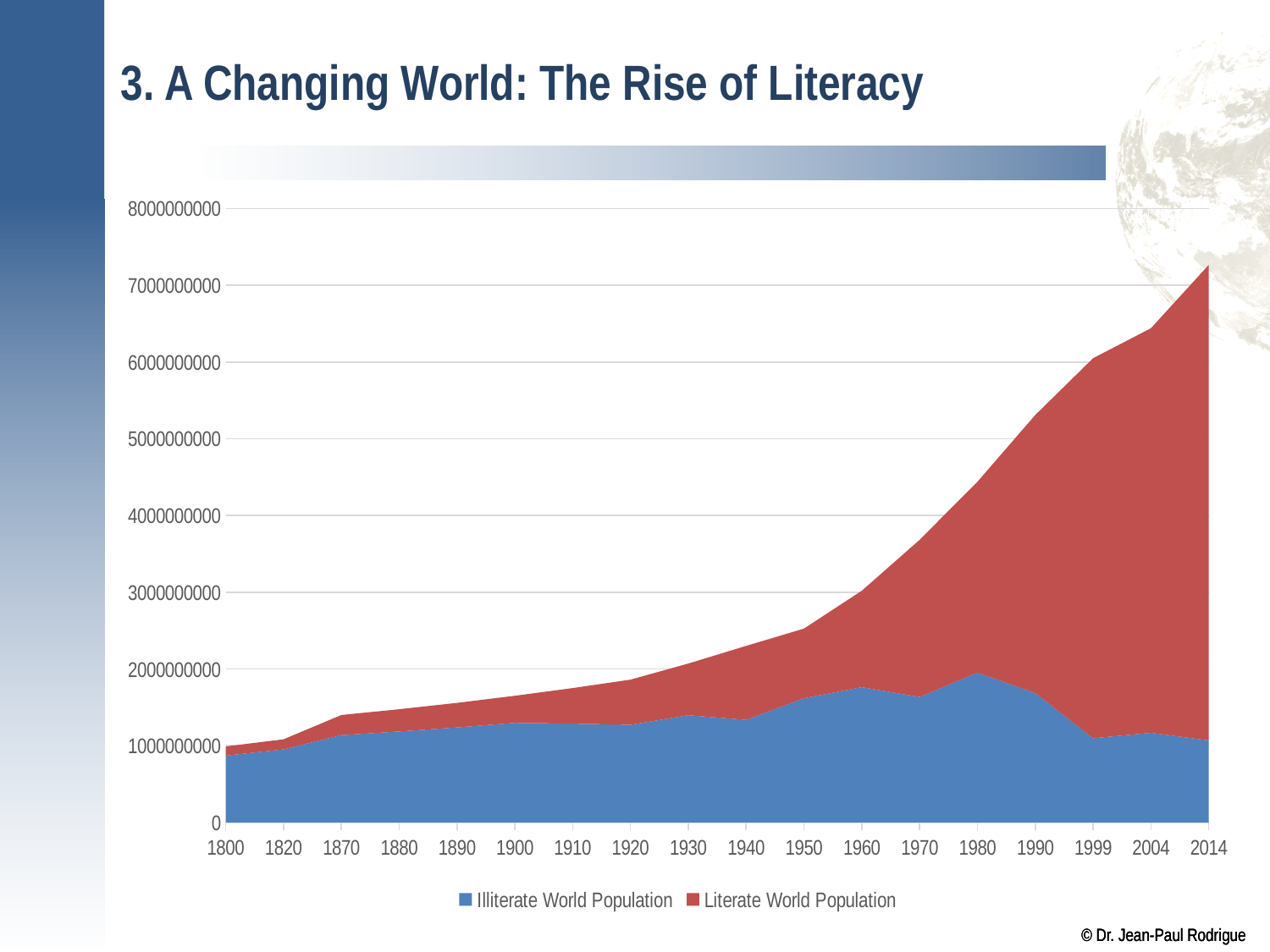
Is the total world population (top of the stacked area) in 1950 greater or less than 2000000000? greater Which series is shown in blue? Illiterate World Population Which series is shown in red? Literate World Population Does the Illiterate World Population rise or fall between 1980 and 1999? fall Is the total world population (top of the stacked area) in 1970 greater or less than 4000000000? less Does the total world population (top of the stacked area) rise or fall from 1800 to 2014? rise How many series does the legend list? 2 How many years are labelled along the x axis? 18 Is the total world population (top of the stacked area) in 1900 greater or less than 2000000000? less What kind of chart is shown on the slide? Stacked area chart